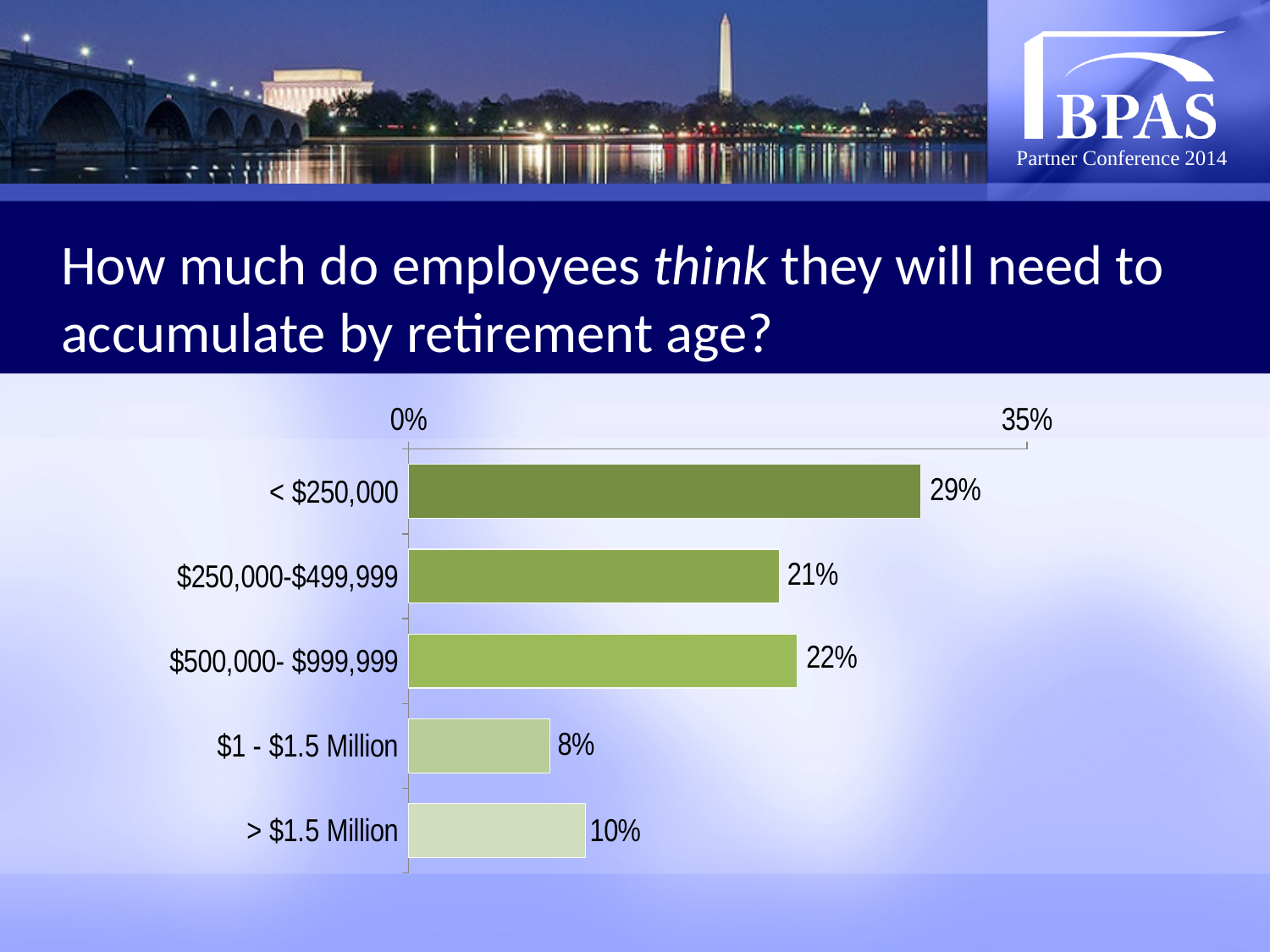
What is the value for the $1 - $1.5 Million category? 8% What kind of chart is shown on the slide? Bar chart What is the value for the $500,000- $999,999 category? 22% Which category has the highest value? < $250,000 What percentage of employees think they will need less than $250,000 by retirement age? 29% What is the difference between the > $1.5 Million value and the $1 - $1.5 Million value? 2% What is the value for the > $1.5 Million category? 10% How many categories are shown in the chart? 5 What is the maximum value shown on the chart's axis? 35% Which is larger, the value for $500,000- $999,999 or the value for $250,000-$499,999? $500,000- $999,999 Which category has the lowest value? $1 - $1.5 Million What is the difference between the < $250,000 value and the $250,000-$499,999 value? 8%